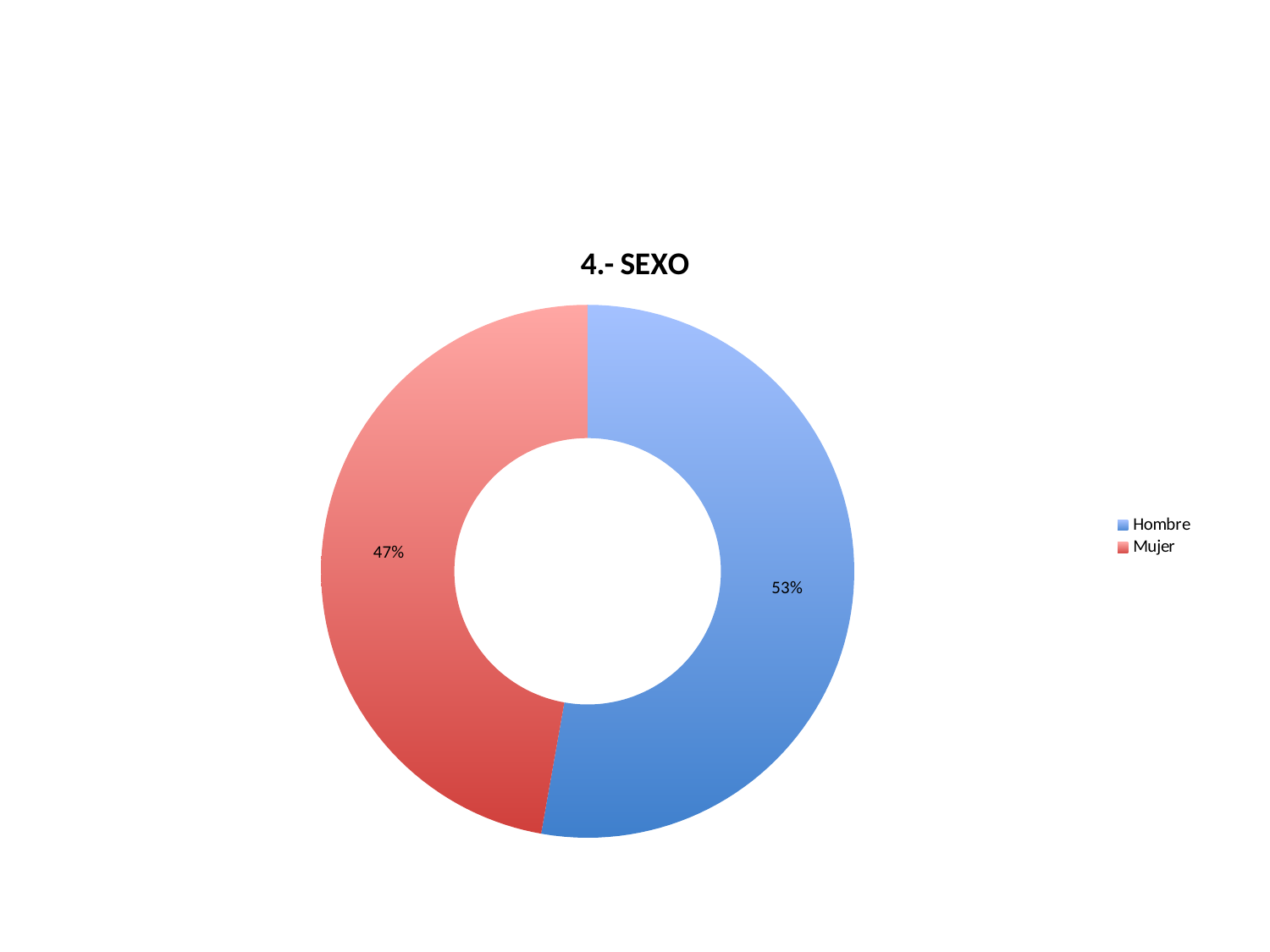
What percentage of the chart is Hombre? 53% How many entries does the legend list? 2 What kind of chart is shown on the slide? Doughnut chart How many categories does the chart show? 2 What percentage of the chart is Mujer? 47% Which category has the smallest share? Mujer Which category has the largest share? Hombre What is the title of the chart? 4.- SEXO What colour represents Mujer in the chart? Red Which is larger, the share for Hombre or the share for Mujer? Hombre What is the difference in percentage points between Hombre and Mujer? 6